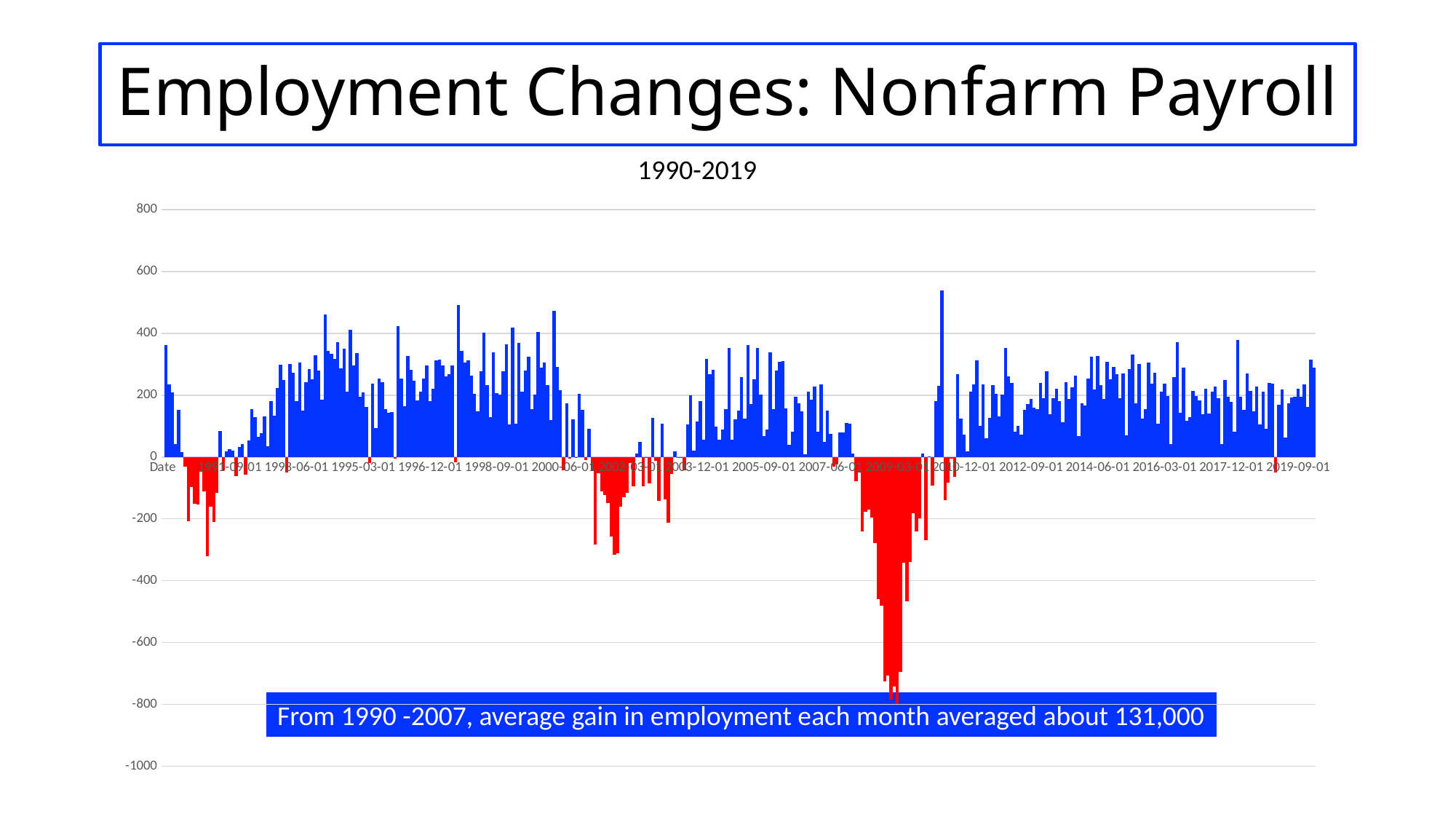
What kind of chart is shown on the slide? bar chart Around which labelled date does the chart show its deepest negative values? 2009-03-01 What subtitle (date range) is shown above the chart? 1990-2019 Is the highest value on the chart greater or less than 400? greater What is the highest value shown on the vertical axis? 800 Is the lowest value on the chart (around 2009) greater or less than -600? less What is the lowest value shown on the vertical axis? -1000 Is the highest value on the chart greater or less than 600? less What colour are the bars representing negative employment changes? red According to the text box on the chart, what was the average monthly employment gain from 1990-2007? about 131,000